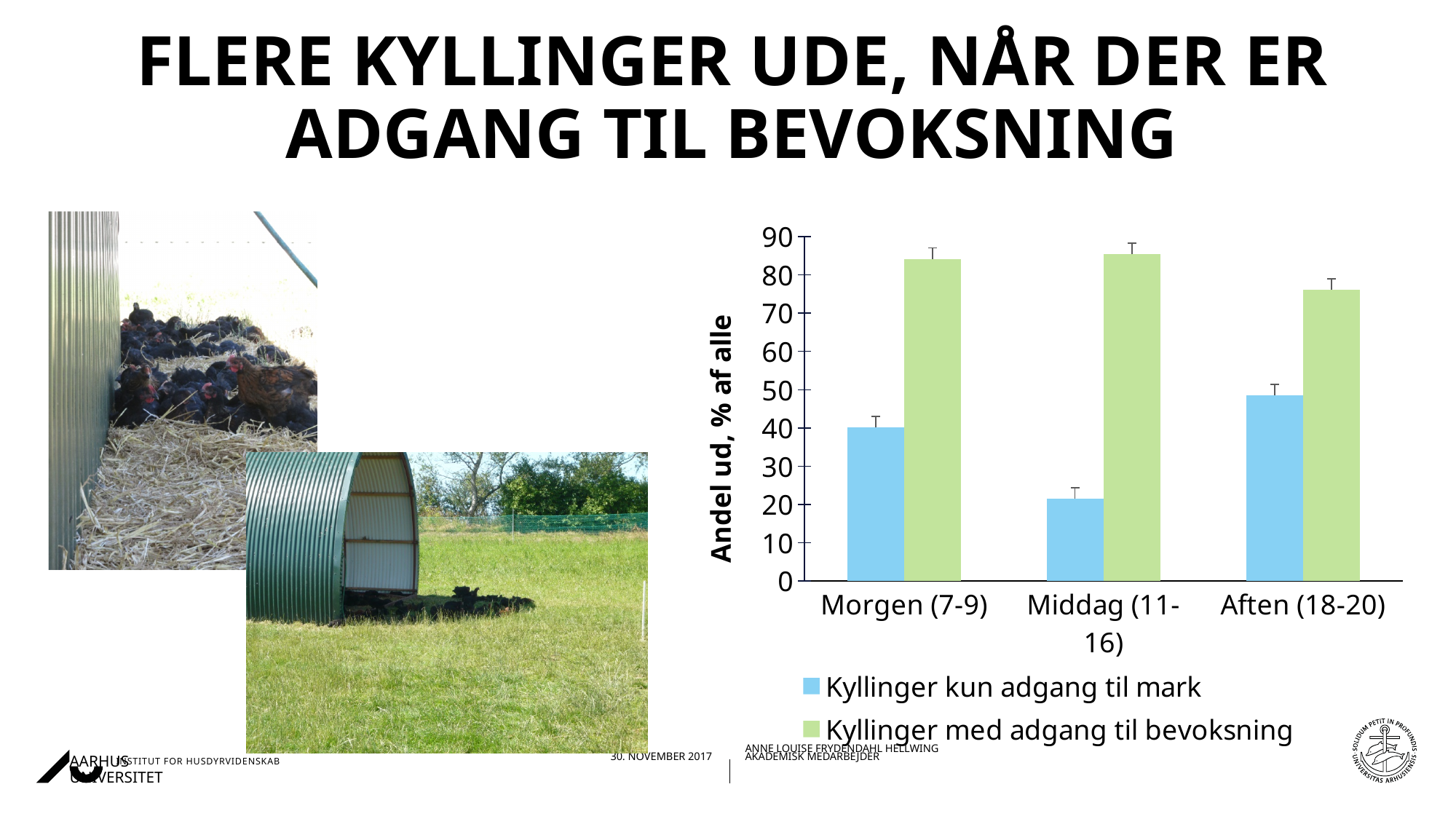
Is the value for Kyllinger med adgang til bevoksning at Aften (18-20) greater or less than 70? greater At Middag (11-16), which series has the larger value: Kyllinger kun adgang til mark or Kyllinger med adgang til bevoksning? Kyllinger med adgang til bevoksning What is the label of the y axis? Andel ud, % af alle For the series Kyllinger med adgang til bevoksning, which category has the lowest value? Aften (18-20) Is the value for Kyllinger med adgang til bevoksning at Morgen (7-9) greater or less than 80? greater For the series Kyllinger kun adgang til mark, which category has the highest value? Aften (18-20) How many time-of-day categories are shown on the x axis? 3 What kind of chart is shown on the slide? bar chart Is the value for Kyllinger kun adgang til mark at Middag (11-16) greater or less than 30? less For the series Kyllinger kun adgang til mark, which category has the lowest value? Middag (11-16) How many series does the legend list? 2